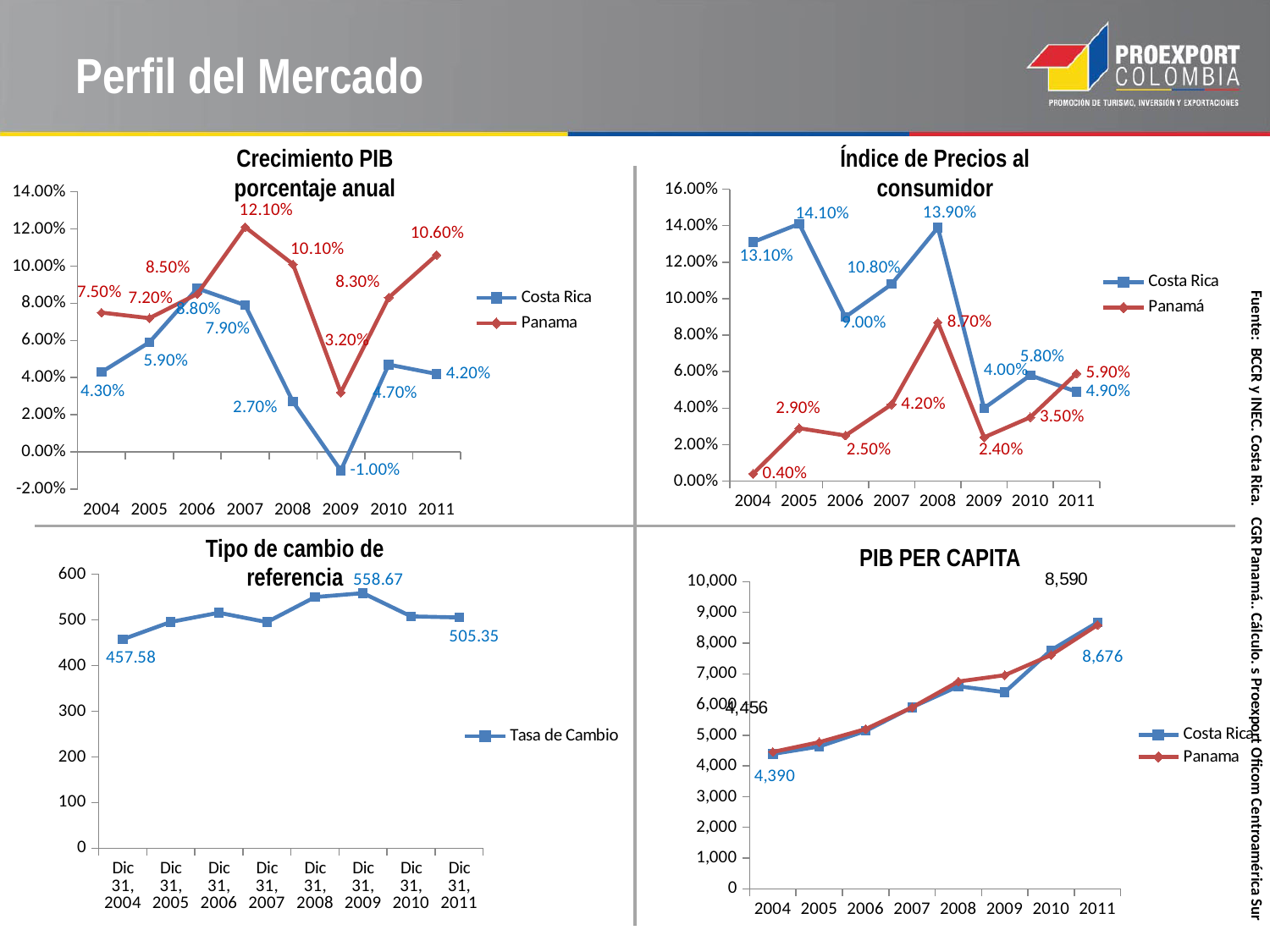
In the 'Tipo de cambio de referencia' chart, what is the value for Dic 31, 2009? 558.67 In the 'Crecimiento PIB porcentaje anual' chart, what is the difference between Panama and Costa Rica in 2011? 6.40% In the 'Crecimiento PIB porcentaje anual' chart, which year has the lowest value for Costa Rica? 2009 In the 'PIB PER CAPITA' chart, what is the value for Costa Rica in 2011? 8,676 In the 'Índice de Precios al consumidor' chart, how many series does the legend list? 2 In the 'Crecimiento PIB porcentaje anual' chart, what is the value for Costa Rica in 2009? -1.00% In the 'Índice de Precios al consumidor' chart, which year has the highest value for Panamá? 2008 In the 'Crecimiento PIB porcentaje anual' chart, what is the value for Panama in 2007? 12.10% In the 'Tipo de cambio de referencia' chart, is the value for Dic 31, 2006 greater or less than 400? greater What kind of chart is 'PIB PER CAPITA'? Line chart In the 'Índice de Precios al consumidor' chart, which is larger in 2011, Costa Rica or Panamá? Panamá In the 'Índice de Precios al consumidor' chart, what is the value for Costa Rica in 2008? 13.90%